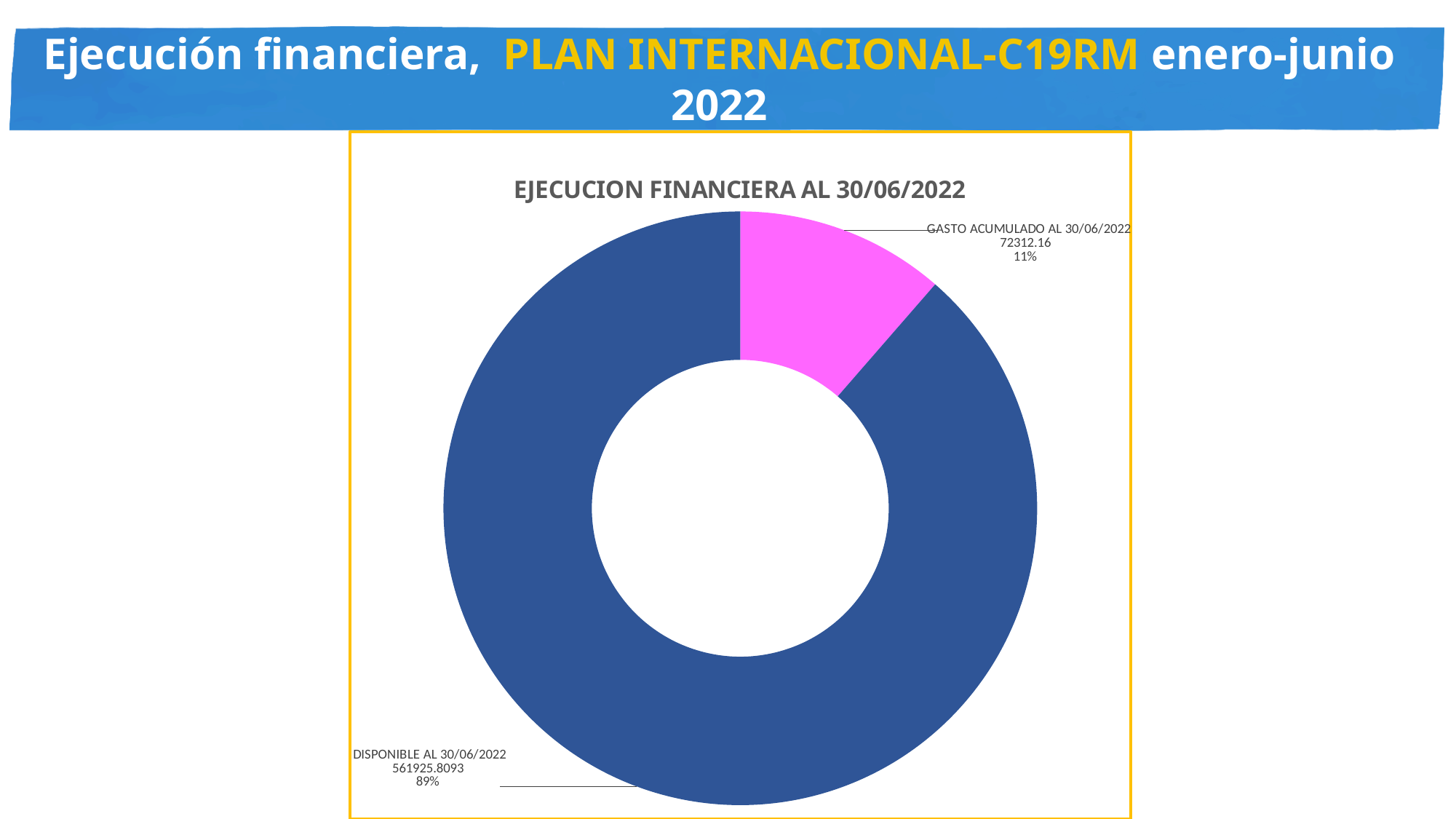
What colour is the GASTO ACUMULADO AL 30/06/2022 slice? Magenta (pink) What share of the chart does the DISPONIBLE AL 30/06/2022 slice represent? 89% What is the value for DISPONIBLE AL 30/06/2022? 561925.8093 What share of the chart does the GASTO ACUMULADO AL 30/06/2022 slice represent? 11% Which category has the largest slice? DISPONIBLE AL 30/06/2022 Which category has the smallest slice? GASTO ACUMULADO AL 30/06/2022 How many categories are shown in the chart? 2 What is the title of the chart? EJECUCION FINANCIERA AL 30/06/2022 What kind of chart is shown on the slide? Doughnut (pie) chart What is the value for GASTO ACUMULADO AL 30/06/2022? 72312.16 Which is larger, DISPONIBLE AL 30/06/2022 or GASTO ACUMULADO AL 30/06/2022? DISPONIBLE AL 30/06/2022